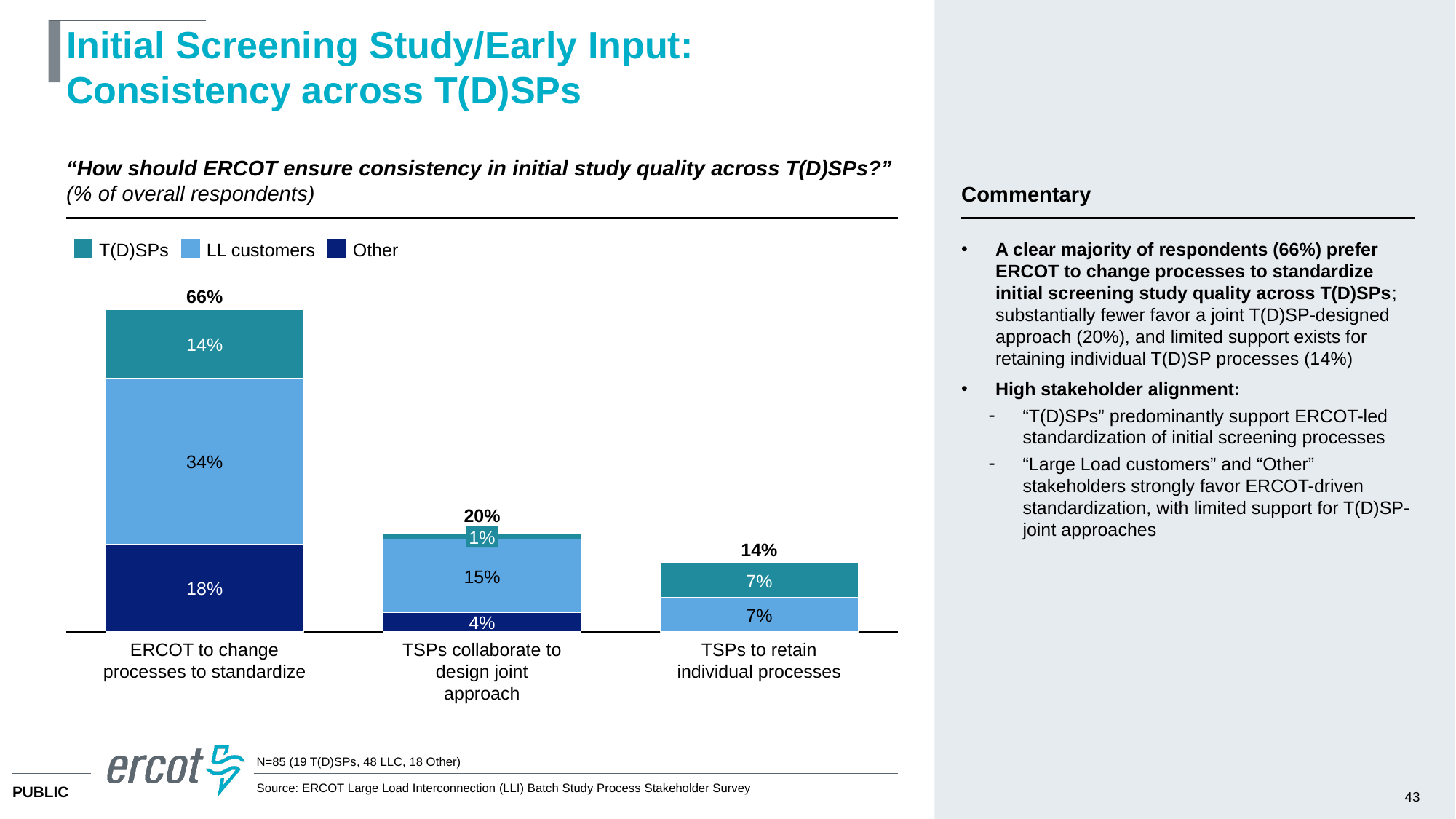
Which is larger: the Other value for 'ERCOT to change processes to standardize' or the LL customers value for 'TSPs collaborate to design joint approach'? Other value for 'ERCOT to change processes to standardize' What is the LL customers value for 'ERCOT to change processes to standardize'? 34% What is the Other value for 'TSPs collaborate to design joint approach'? 4% What kind of chart is shown? Stacked bar chart What is the T(D)SPs value for 'TSPs collaborate to design joint approach'? 1% What is the T(D)SPs value for 'TSPs to retain individual processes'? 7% Which category has the lowest total? TSPs to retain individual processes How many categories are shown on the x axis? 3 What is the total for the 'ERCOT to change processes to standardize' bar? 66% What is the difference between the totals for 'ERCOT to change processes to standardize' and 'TSPs collaborate to design joint approach'? 46% Which category has the highest total? ERCOT to change processes to standardize How many series does the legend list? 3